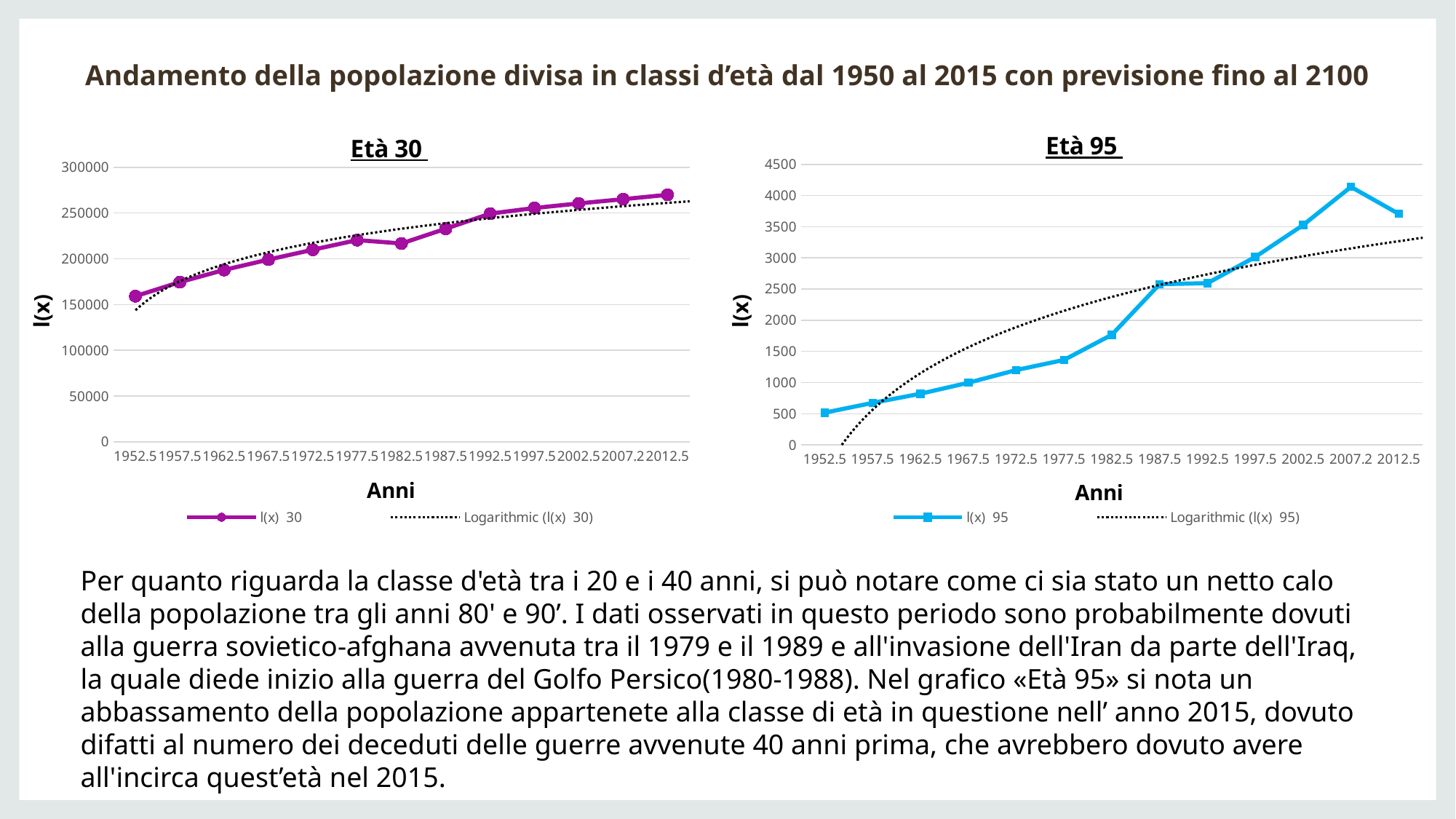
In the "Età 30" chart, is the value for 2012.5 greater or less than 250000? greater What is the label of the x axis on the "Età 95" chart? Anni In the "Età 95" chart, which year has the lowest value of l(x) 95? 1952.5 How many entries does the legend of the "Età 30" chart list? 2 How many years are plotted on the x axis of the "Età 95" chart? 13 In the "Età 95" chart, which year has the highest value of l(x) 95? 2007.2 In the "Età 30" chart, do the values of l(x) 30 generally rise or fall from 1952.5 to 2012.5? rise In the "Età 95" chart, which is larger, the value for 2007.2 or the value for 2012.5? 2007.2 What kind of chart is the "Età 30" chart? line chart In the "Età 95" chart, is the value for 2012.5 greater or less than 3500? greater In the "Età 30" chart, which year has the highest value of l(x) 30? 2012.5 In the "Età 30" chart, is the value for 1952.5 greater or less than 200000? less